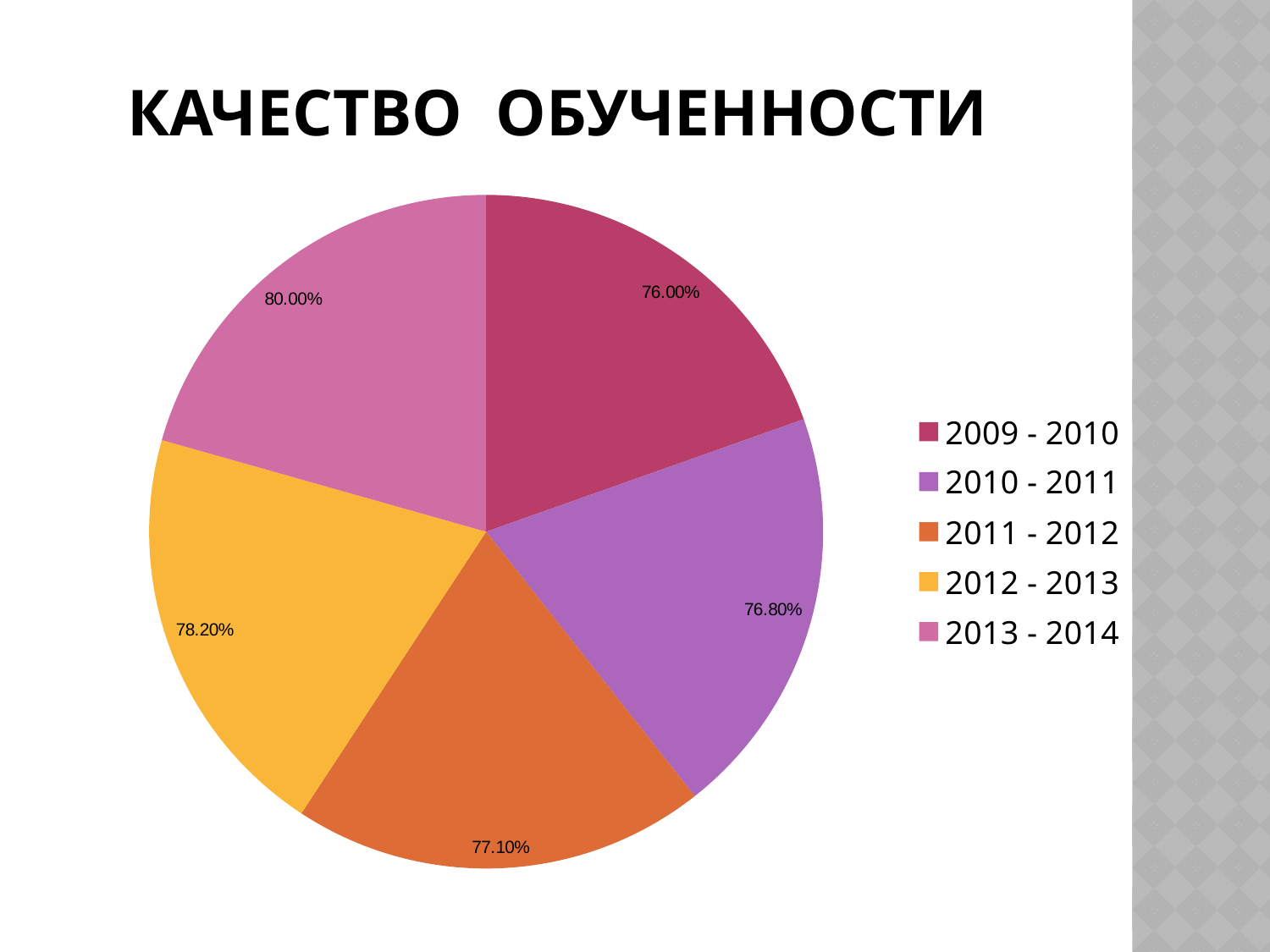
Do the values rise or fall from 2009 - 2010 to 2013 - 2014? rise Which period has the highest value? 2013 - 2014 What type of chart is shown on the slide? pie chart What is the difference between the values for 2013 - 2014 and 2009 - 2010? 4.00% What value is shown for 2011 - 2012? 77.10% Which period has the lowest value? 2009 - 2010 Which is larger, the value for 2010 - 2011 or the value for 2012 - 2013? 2012 - 2013 How many slices does the pie chart have? 5 What value is shown for 2009 - 2010? 76.00% How many entries does the legend list? 5 What value is shown for 2012 - 2013? 78.20% What is the title of the chart? КАЧЕСТВО ОБУЧЕННОСТИ